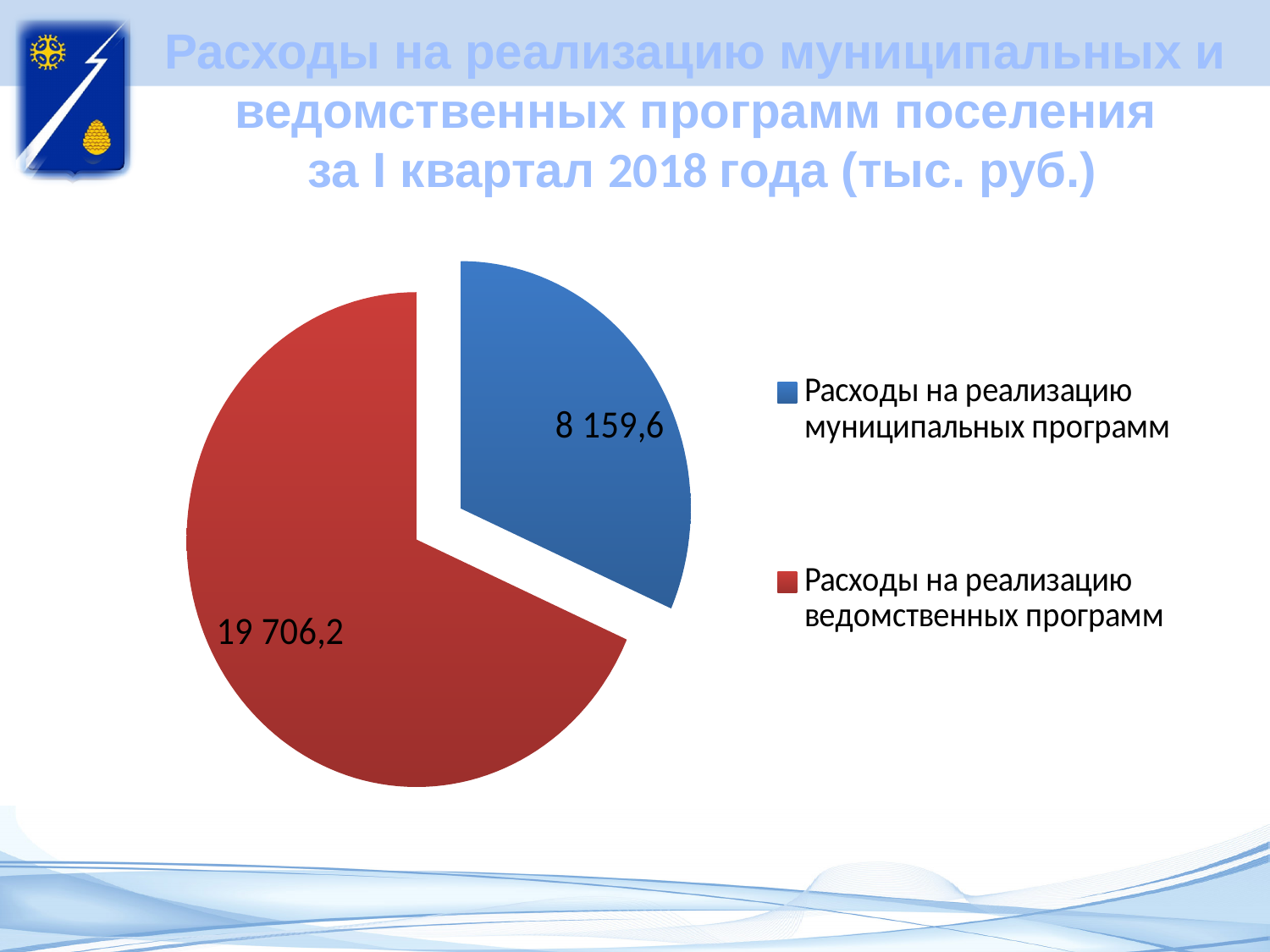
What is the value for Расходы на реализацию ведомственных программ? 19 706,2 What is the difference between the value for ведомственных программ and the value for муниципальных программ? 11 546,6 Which category has the largest slice of the pie? Расходы на реализацию ведомственных программ Which category has the smallest slice of the pie? Расходы на реализацию муниципальных программ Which is larger: the value for муниципальных программ or the value for ведомственных программ? Расходы на реализацию ведомственных программ What is the value for Расходы на реализацию муниципальных программ? 8 159,6 How many entries does the legend list? 2 What is the total of the two slices in the pie chart? 27 865,8 What kind of chart is shown on the slide? Pie chart How many slices does the pie chart have? 2 What colour is the slice for Расходы на реализацию муниципальных программ? Blue